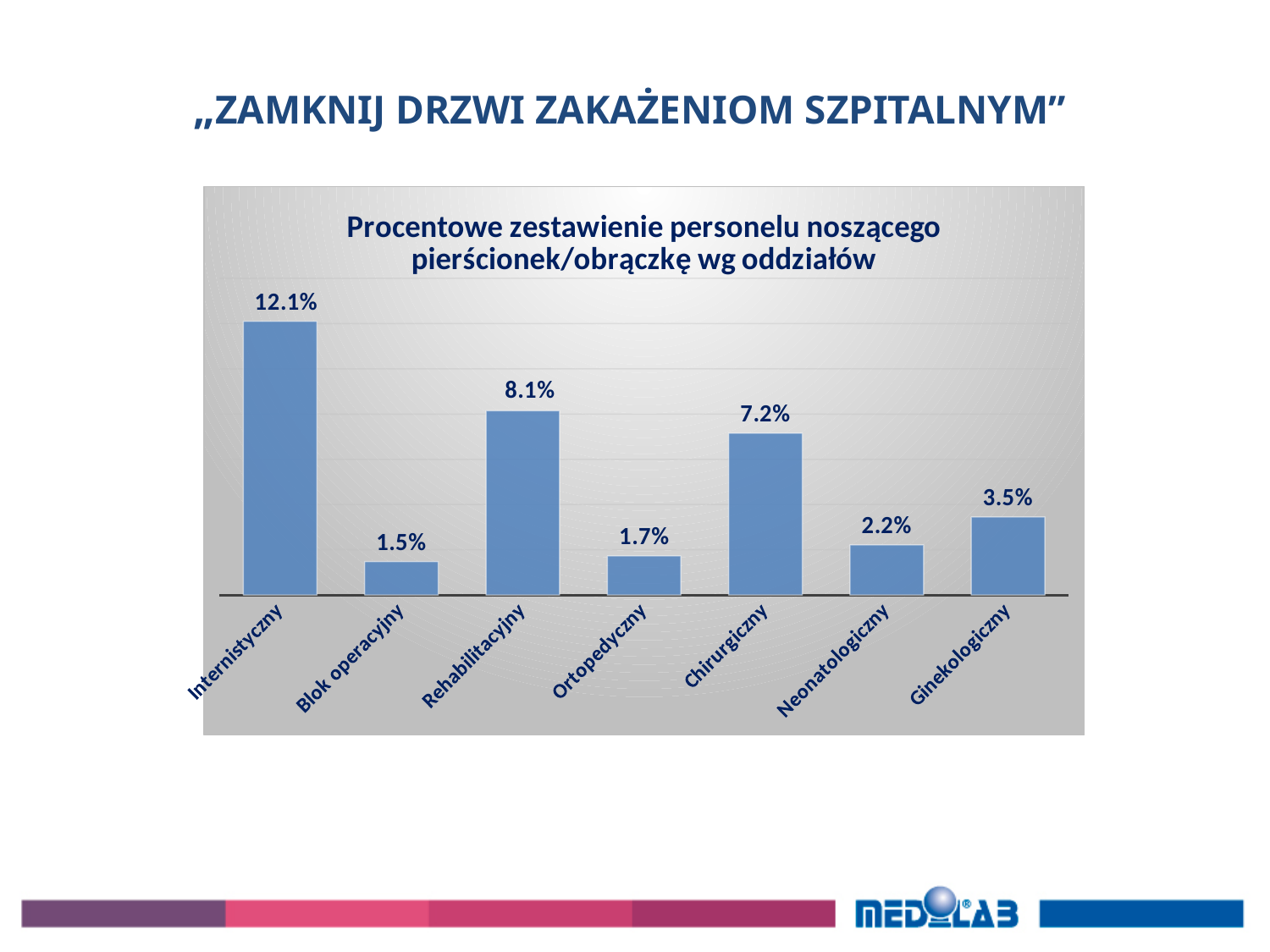
What is the value for Blok operacyjny? 1.5% Which department has the highest value? Internistyczny What is the title of the chart? Procentowe zestawienie personelu noszącego pierścionek/obrączkę wg oddziałów Which department has the lowest value? Blok operacyjny Which is larger, the value for Rehabilitacyjny or the value for Chirurgiczny? Rehabilitacyjny What is the difference between the values for Ginekologiczny and Neonatologiczny? 1.3% What is the value for Internistyczny? 12.1% What is the value for Ginekologiczny? 3.5% What is the difference between the values for Internistyczny and Rehabilitacyjny? 4.0% How many departments are shown on the chart? 7 What is the value for Chirurgiczny? 7.2% What kind of chart is shown on the slide? Bar chart